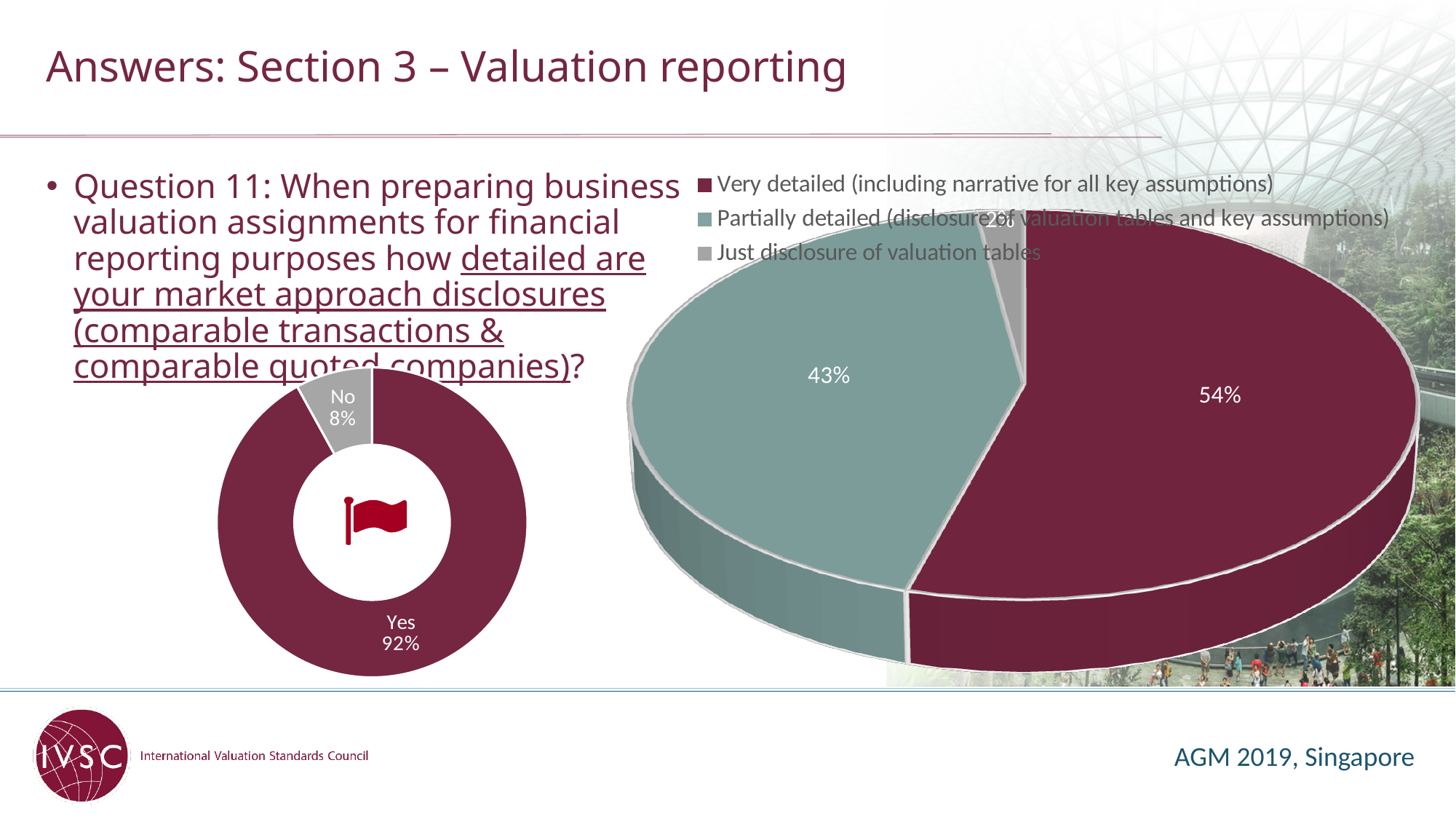
On the large pie chart on the right, what colour is the 'Partially detailed' slice? Grey-green (teal) On the small donut chart on the left, how many categories are shown? 2 On the small donut chart on the left, what percentage is labelled 'Yes'? 92% On the small donut chart on the left, what percentage is labelled 'No'? 8% On the large pie chart on the right, what share is labelled for the 'Very detailed (including narrative for all key assumptions)' slice? 54% On the large pie chart on the right, which category has the smallest slice? Just disclosure of valuation tables On the large pie chart on the right, which is larger: the 'Very detailed' slice or the 'Partially detailed' slice? Very detailed On the large pie chart on the right, how many entries does the legend list? 3 On the large pie chart on the right, which category has the largest slice? Very detailed (including narrative for all key assumptions) On the large pie chart on the right, what is the difference in percentage points between the 'Very detailed' and 'Partially detailed' slices? 11 percentage points On the large pie chart on the right, what share is labelled for the 'Partially detailed (disclosure of valuation tables and key assumptions)' slice? 43% What kind of chart is the large chart on the right of the slide? Pie chart